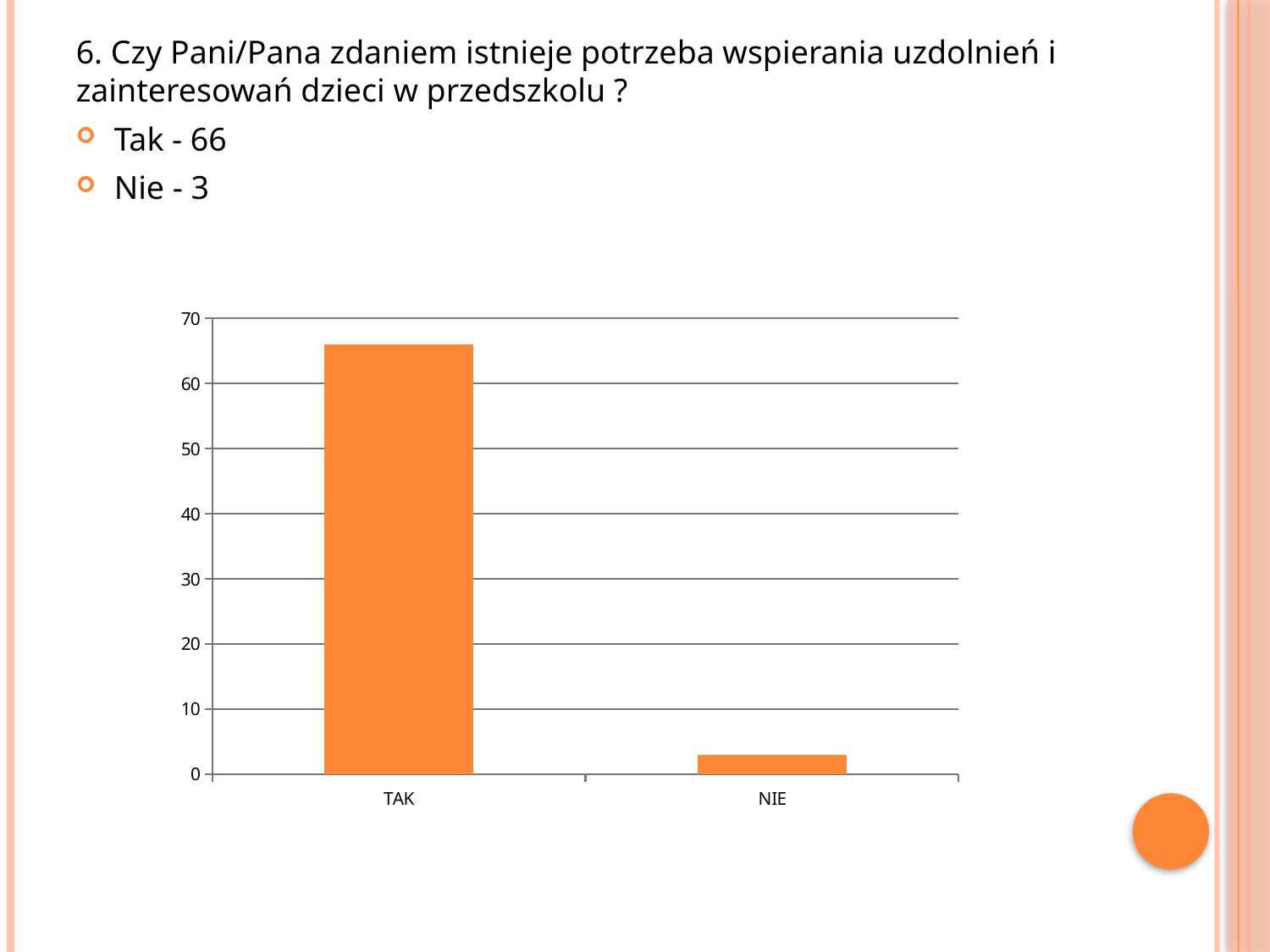
How many categories are shown on the x axis of the chart? 2 What type of chart is shown on the slide? bar chart Which category has the highest bar in the chart? TAK Which category has the lowest bar in the chart? NIE What colour are the bars in the chart? orange What is the highest value shown on the y axis of the chart? 70 According to the slide, what is the value for Tak? 66 According to the slide, what is the value for Nie? 3 What is the difference between the values for Tak and Nie given on the slide? 63 Is the bar for TAK taller or shorter than the bar for NIE? taller Is the value for NIE greater or less than 10? less Is the value for TAK greater or less than 60? greater